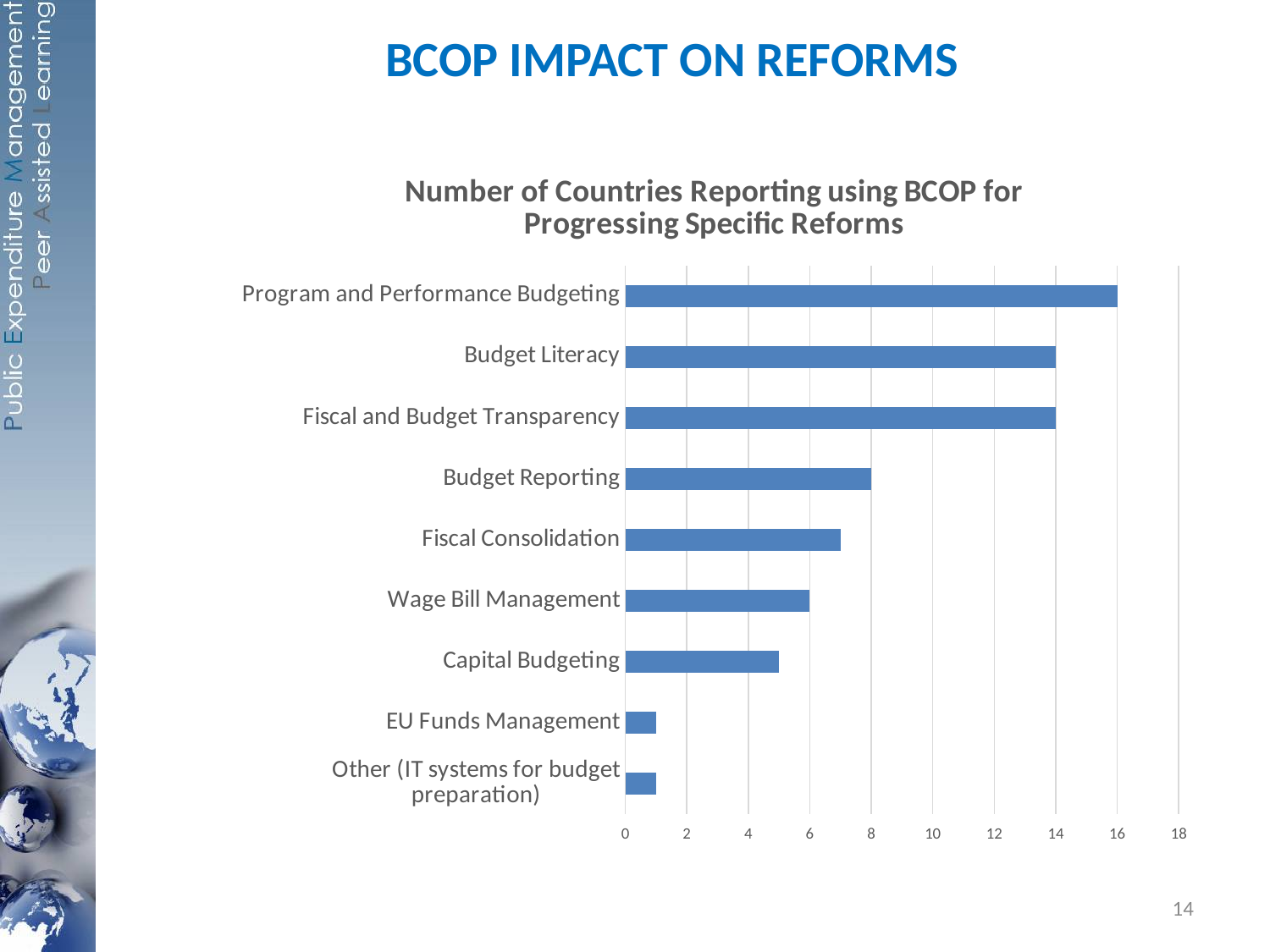
How many countries reported using BCOP for Budget Reporting? 8 What type of chart is shown on the slide? bar chart How many countries reported using BCOP for Wage Bill Management? 6 Is the value for Capital Budgeting greater or less than 6? less Which reform has the highest number of countries reporting? Program and Performance Budgeting How many countries reported using BCOP for Program and Performance Budgeting? 16 How many countries reported using BCOP for Budget Literacy? 14 How many reform categories are plotted in the chart? 9 Which has a larger value, Budget Reporting or Wage Bill Management? Budget Reporting Is the value for Fiscal Consolidation greater or less than 6? greater What is the difference between the values for Program and Performance Budgeting and Budget Reporting? 8 What is the title of the chart? Number of Countries Reporting using BCOP for Progressing Specific Reforms